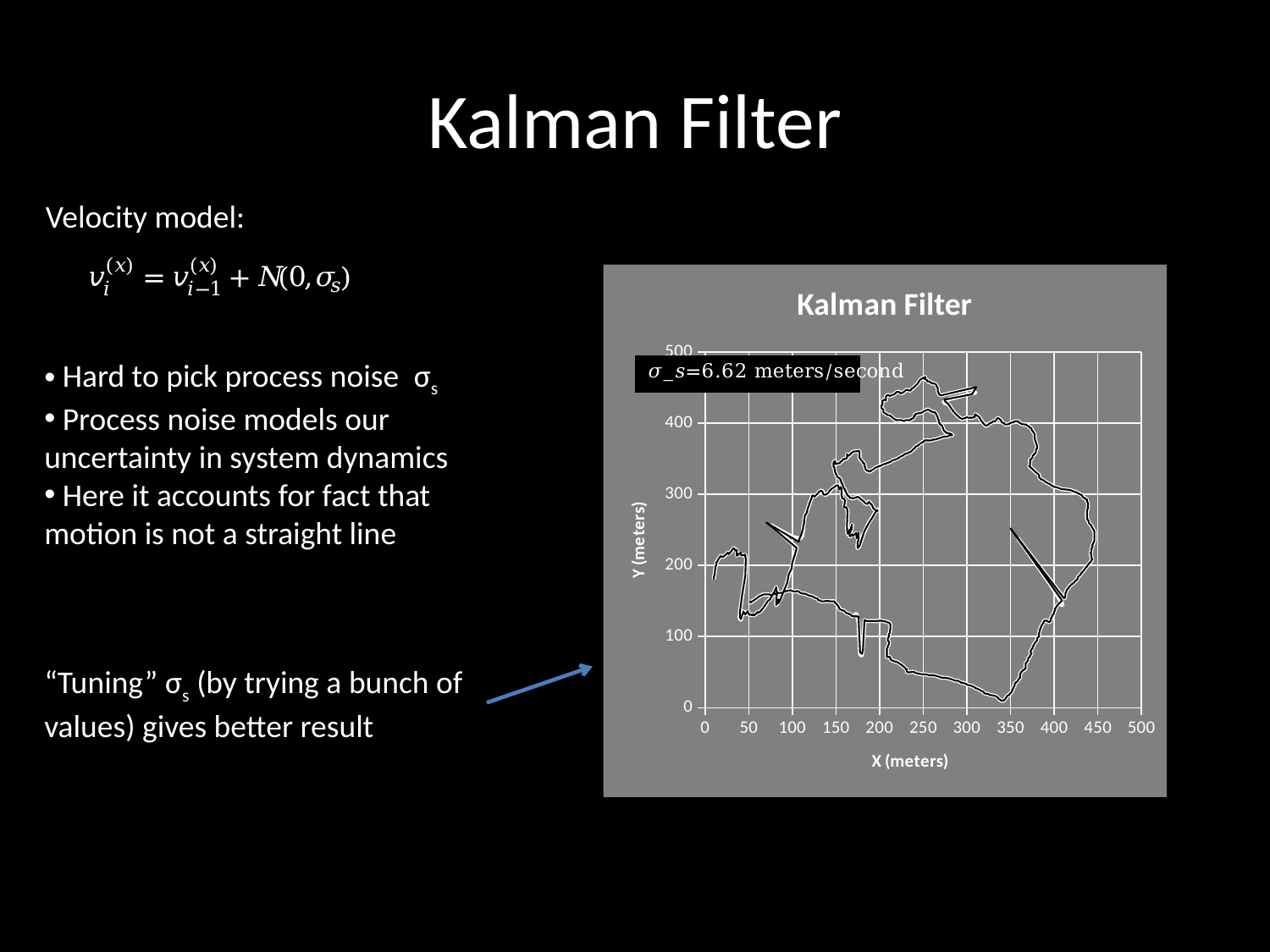
Is the highest Y value reached by the plotted path greater or less than 500? less Is the lowest Y value reached by the plotted path greater or less than 50? less Is the highest Y value reached by the plotted path greater or less than 400? greater What value of σ_s is annotated on the chart? 6.62 meters/second What is the title of the chart? Kalman Filter What kind of chart is shown on the slide? line chart